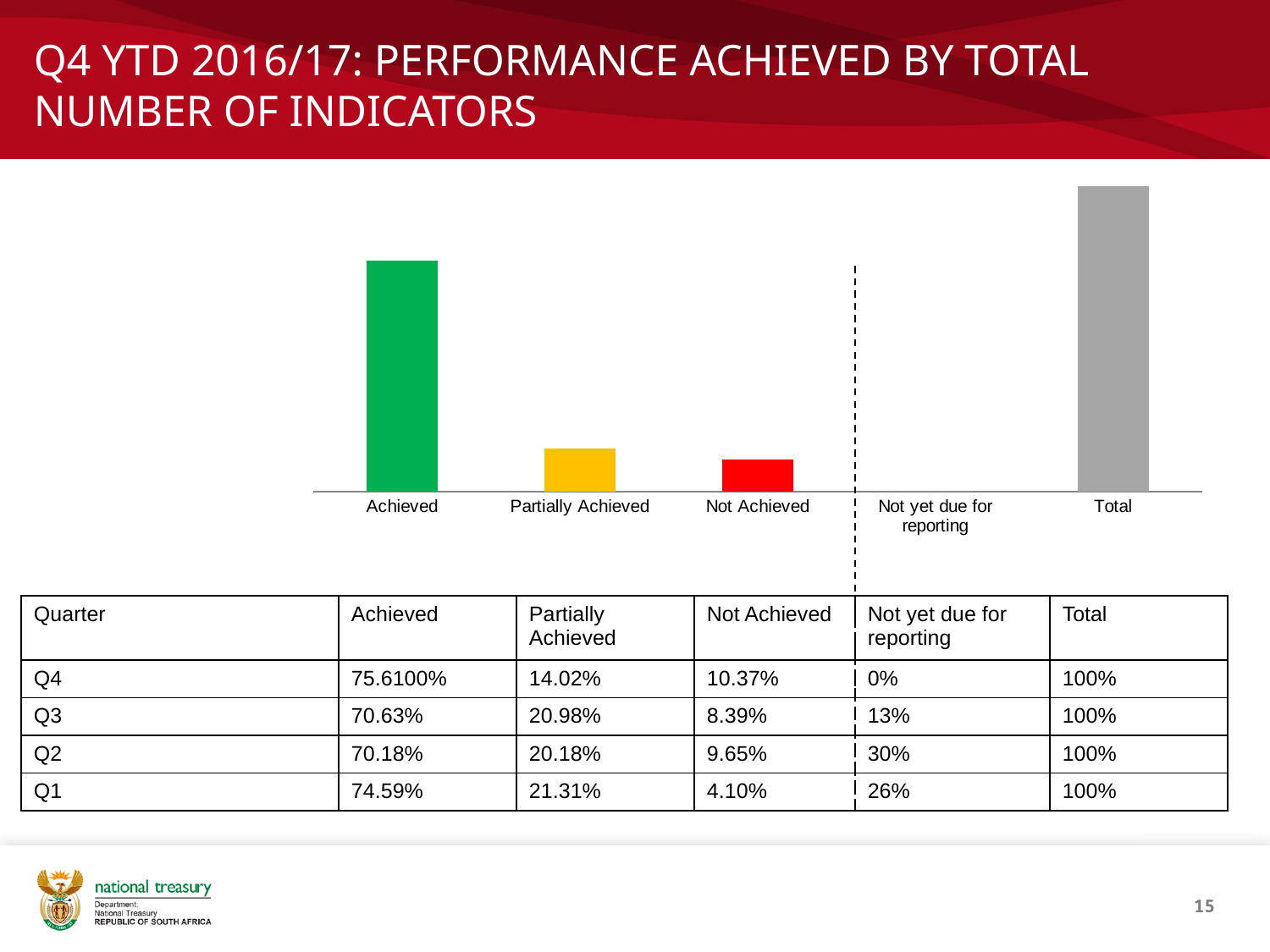
Which category has the lowest value in the chart? Not yet due for reporting What colour is the Achieved bar in the chart? green Which category has the tallest bar in the chart? Total Which bar is taller in the chart, Partially Achieved or Not Achieved? Partially Achieved Which bar is taller in the chart, Achieved or Partially Achieved? Achieved According to the Q4 row of the table, what is the value for Achieved shown in the chart? 75.6100% How many categories are shown on the x axis of the chart? 5 According to the Q4 row of the table, what is the value for Not Achieved shown in the chart? 10.37% What kind of chart is shown on the slide? bar chart According to the Q4 row of the table, what is the value for Partially Achieved shown in the chart? 14.02% Excluding Total, which category has the tallest bar in the chart? Achieved Using the Q4 values in the table, what is the difference between Partially Achieved and Not Achieved? 3.65%